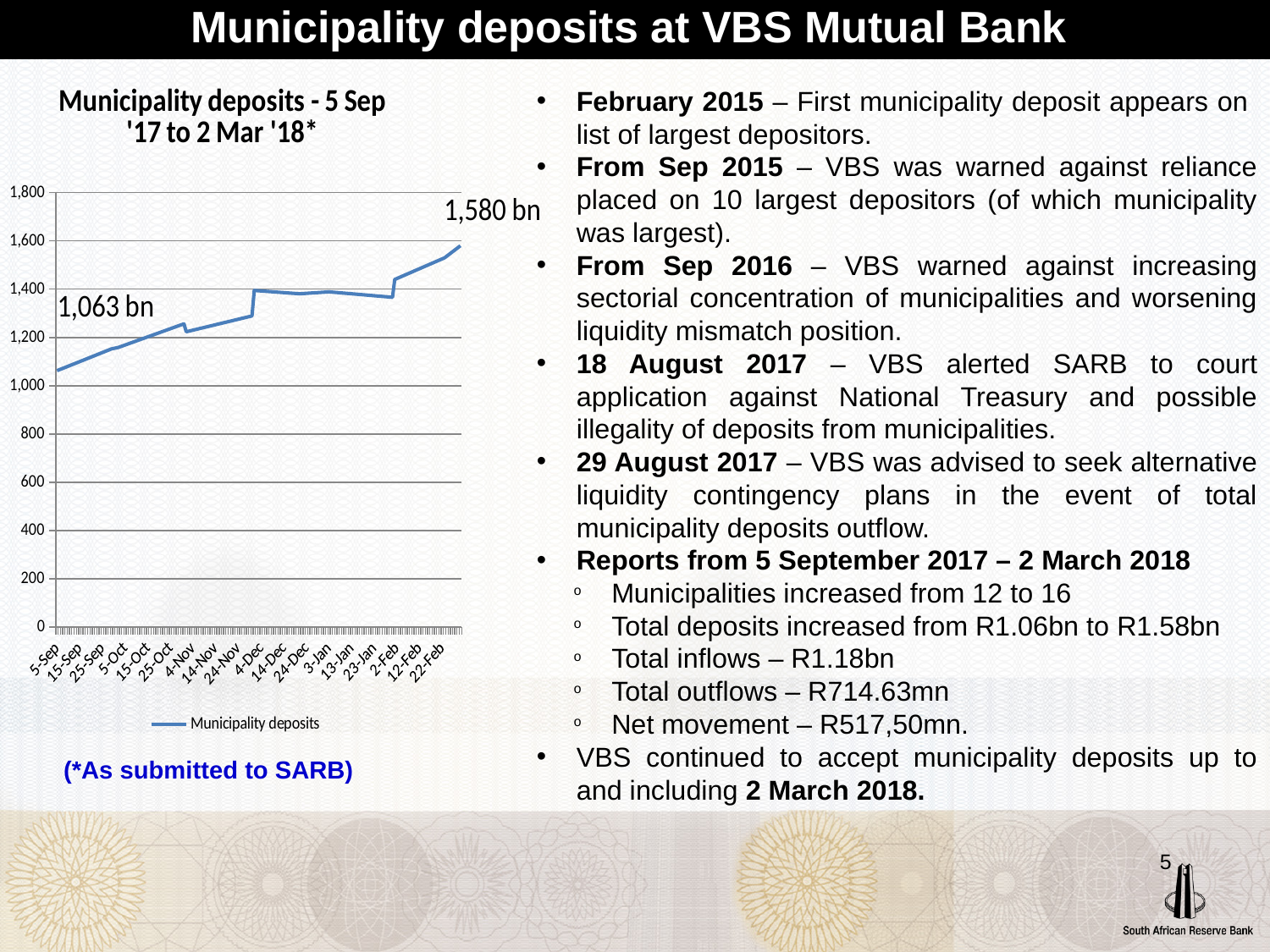
How many series does the legend list? 1 What is the value labelled at the start of the line (5-Sep)? 1,063 bn What is the value labelled at the end of the line (2 Mar '18)? 1,580 bn Do municipality deposits generally rise or fall from 5-Sep to the end of the period? rise What kind of chart is shown on the slide? line chart What is the title of the chart? Municipality deposits - 5 Sep '17 to 2 Mar '18* What series name is shown in the legend? Municipality deposits Is the value for 15-Oct greater or less than 1,400? less Which of the two labelled values is larger, the start value or the end value? the end value (1,580 bn) What is the difference between the labelled end value and the labelled start value of the line? 517 bn Is the value for 4-Dec greater or less than 1,200? greater What is the highest value shown on the y axis? 1,800